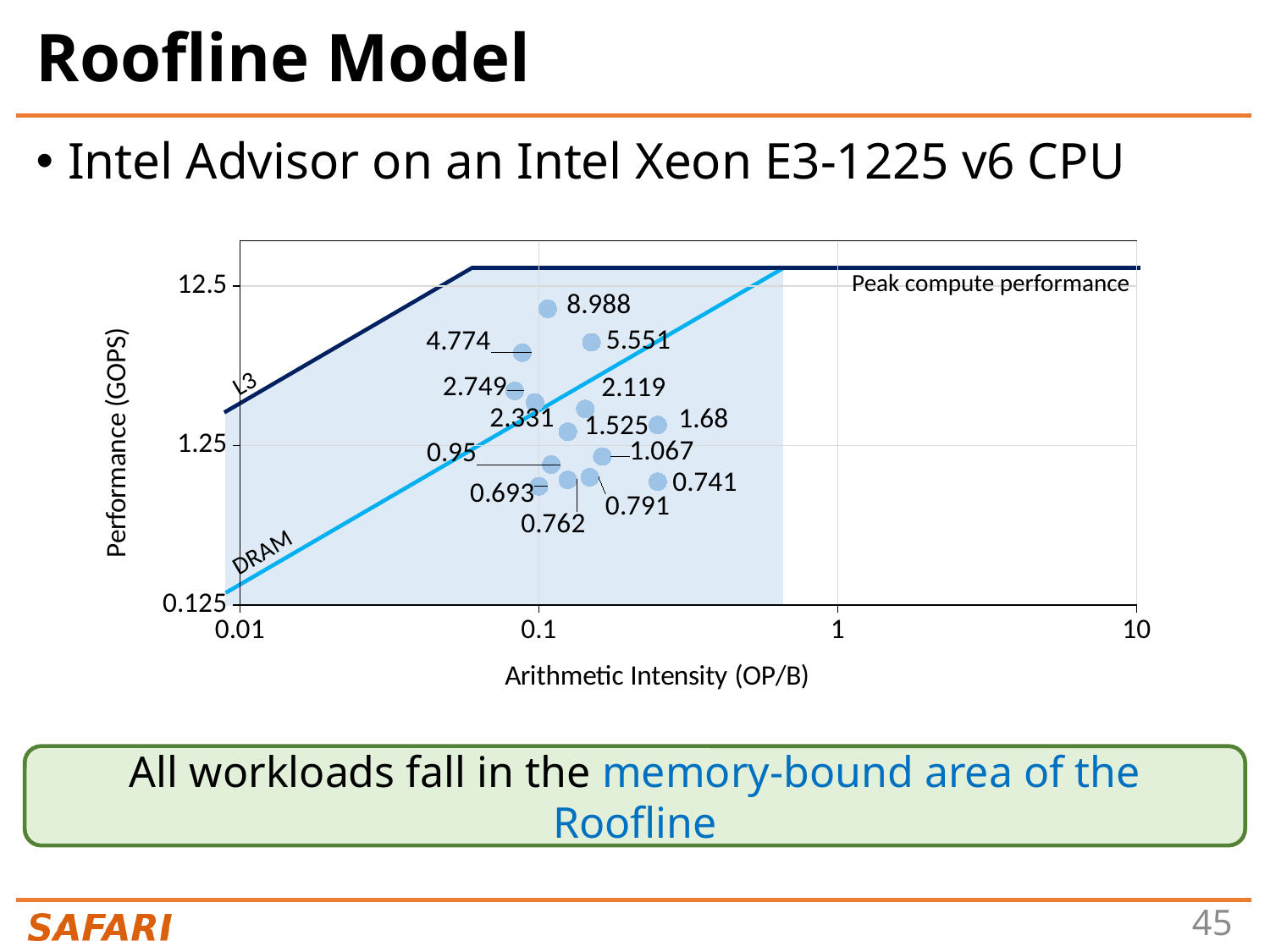
Is the highest labeled workload point (8.988) greater or less than the 12.5 GOPS tick on the y axis? less Which labeled point has the larger value, 5.551 or 4.774? 5.551 What is the difference between the points labeled 2.749 and 2.331? 0.418 Is the point labeled 0.693 greater or less than 1.25 GOPS? less What is the title of the x axis of the chart? Arithmetic Intensity (OP/B) What is the highest performance value labeled among the plotted workload points? 8.988 How many labeled workload data points are plotted on the chart? 14 What is the difference between the highest labeled point (8.988) and the lowest labeled point (0.693)? 8.295 What is the lowest performance value labeled among the plotted workload points? 0.693 What kind of chart is shown on the slide? scatter chart What is the difference between the points labeled 5.551 and 4.774? 0.777 What are the two memory roofline lines on the chart labeled? L3 and DRAM